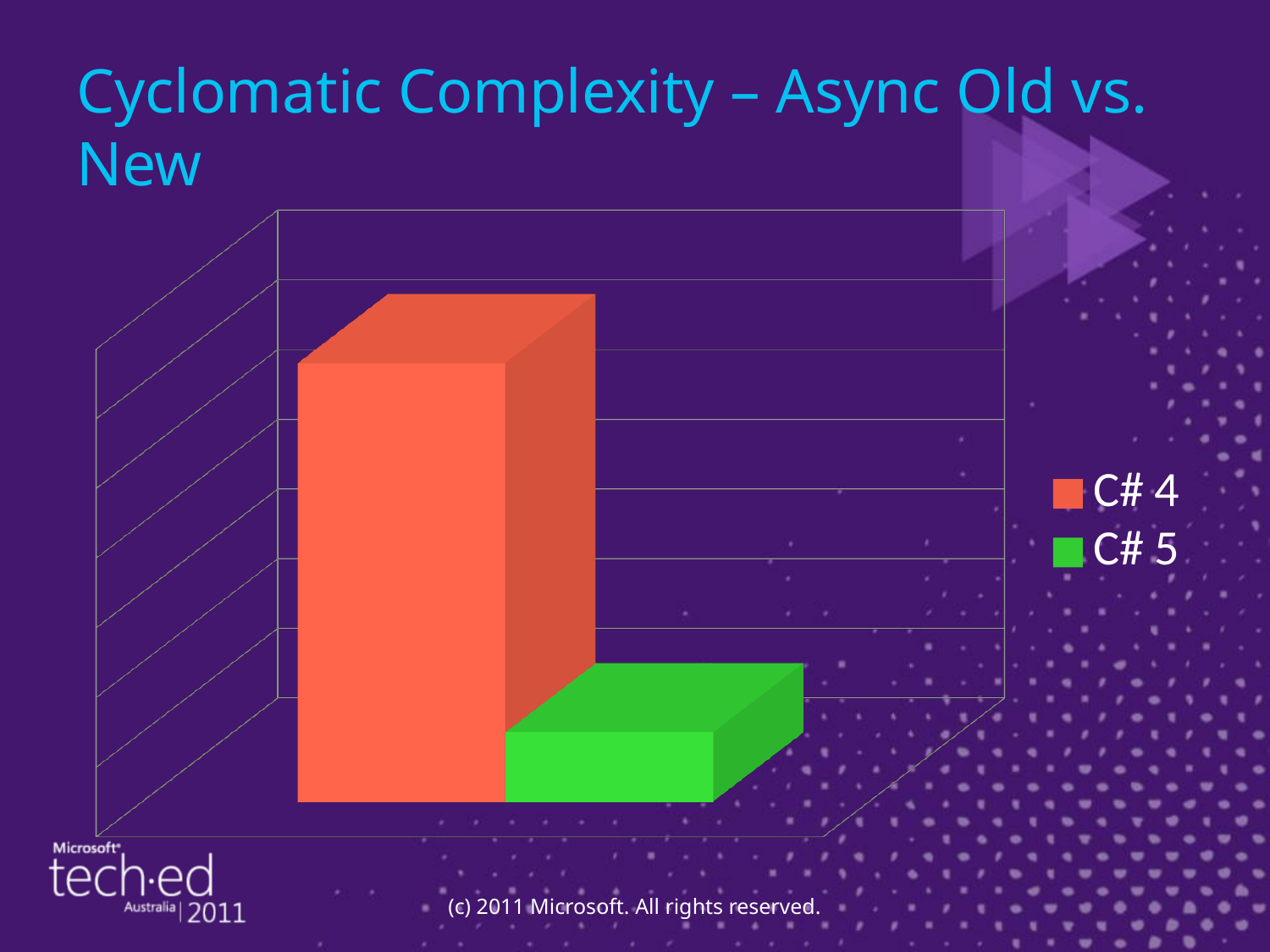
What kind of chart is shown on the slide? bar chart What colour is the bar for C# 5 in the chart? green How many series does the chart legend list? 2 How many bars are plotted in the chart? 2 Is the bar for C# 5 taller or shorter than the bar for C# 4? shorter Which series has the lowest value in the chart? C# 5 Which series has the taller bar, C# 4 or C# 5? C# 4 What is the title of the slide containing the chart? Cyclomatic Complexity – Async Old vs. New Which series has the highest value in the chart? C# 4